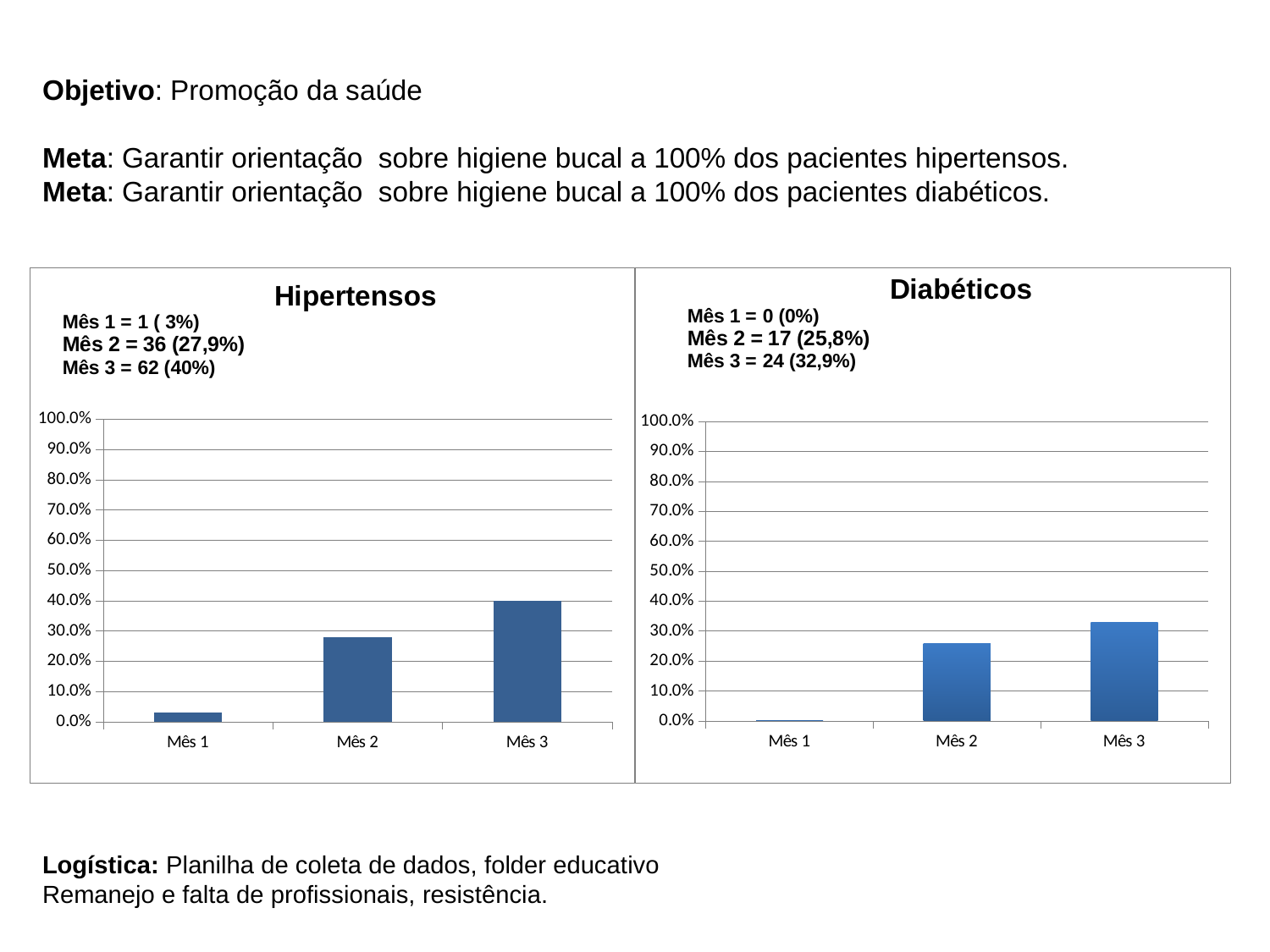
Which is larger: the Mês 3 value in the Hipertensos chart or the Mês 3 value in the Diabéticos chart? Hipertensos How many months (categories) are shown on the x axis of the Diabéticos chart? 3 In the Hipertensos chart, is the value for Mês 2 greater or less than 20.0%? greater What type of chart is the Hipertensos chart? bar chart In the Hipertensos chart, what percentage is shown for Mês 3? 40% In the Hipertensos chart, what percentage is shown for Mês 2? 27,9% In the Diabéticos chart, which month has the lowest value? Mês 1 In the Diabéticos chart, what percentage is shown for Mês 3? 32,9% What is the title of the chart on the right side of the slide? Diabéticos In the Diabéticos chart, what percentage is shown for Mês 2? 25,8% In the Hipertensos chart, which month has the highest value? Mês 3 In the Hipertensos chart, do the values rise or fall from Mês 1 to Mês 3? rise